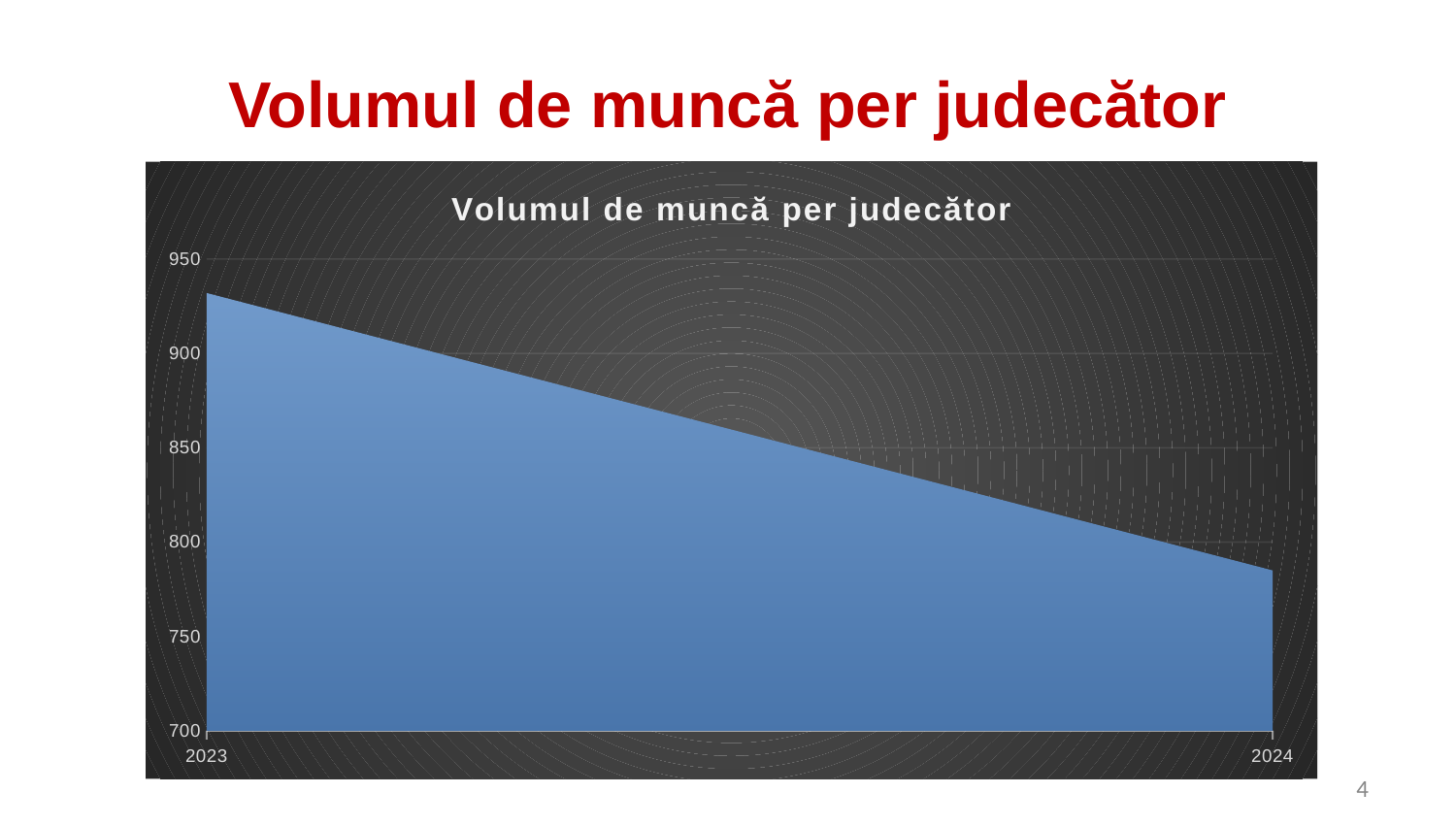
How many years are plotted on the x axis of the chart? 2 Is the value for 2024 greater or less than 750? greater Is the value for 2023 greater or less than 950? less What is the lowest value shown on the chart's y axis? 700 Is the value for 2023 greater or less than 900? greater What is the title of the chart? Volumul de muncă per judecător Which year has the highest value in the chart? 2023 What kind of chart is shown on the slide? Area chart Which year has the higher value, 2023 or 2024? 2023 Which year has the lowest value in the chart? 2024 Does the value rise or fall from 2023 to 2024? Fall